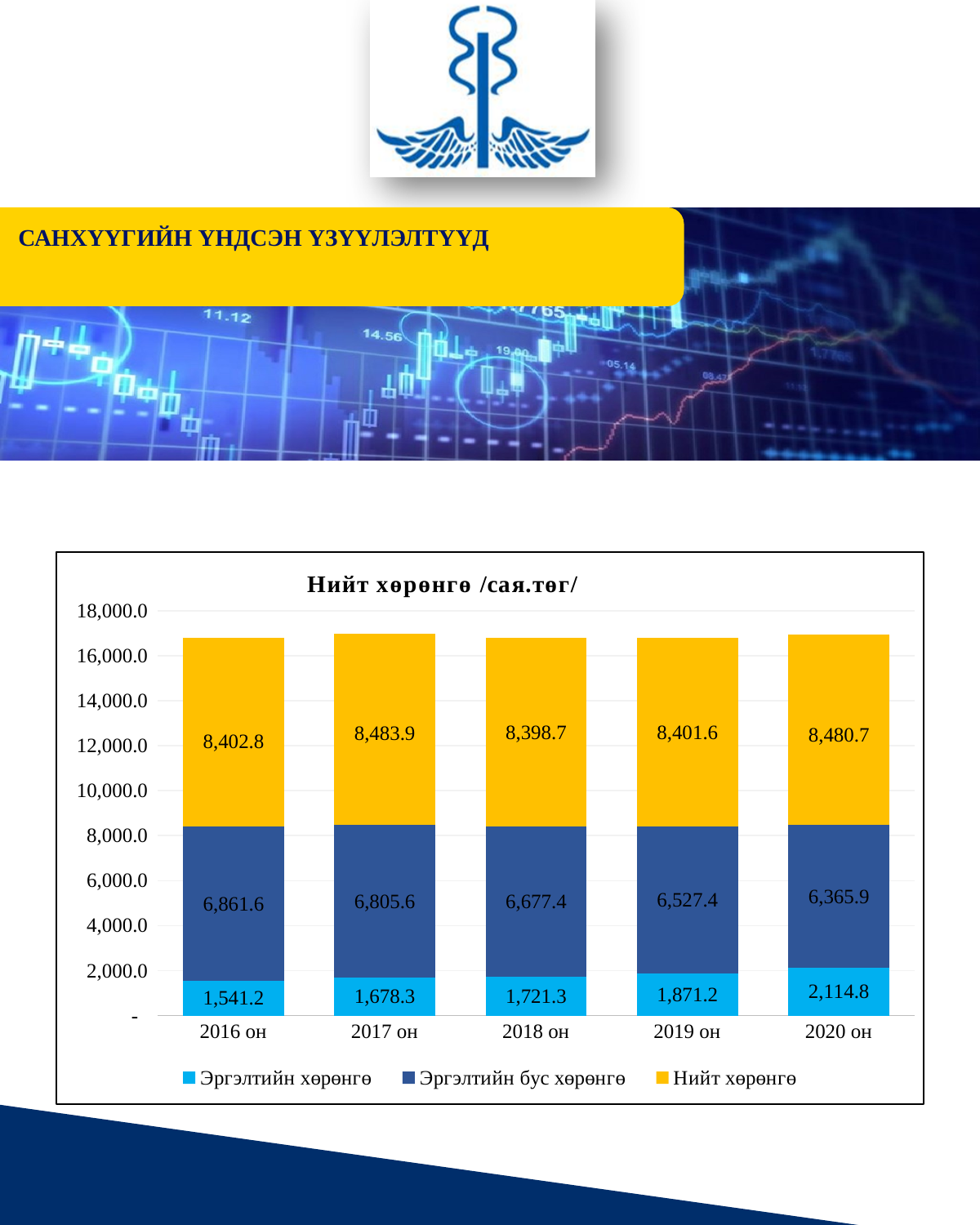
In which year is Эргэлтийн бус хөрөнгө lowest? 2020 он What is the value of Эргэлтийн хөрөнгө for 2016 он? 1,541.2 What kind of chart is shown? Stacked bar chart How does Эргэлтийн хөрөнгө change from 2016 он to 2020 он? It rises every year What is the difference between Эргэлтийн хөрөнгө in 2020 он and in 2016 он? 573.6 How many series does the legend list? 3 How many years are shown on the x axis? 5 In which year is Эргэлтийн хөрөнгө highest? 2020 он What is the value of Нийт хөрөнгө for 2018 он? 8,398.7 What is the value of Эргэлтийн бус хөрөнгө for 2019 он? 6,527.4 What is the title of the chart? Нийт хөрөнгө /сая.төг/ Which is larger: Эргэлтийн бус хөрөнгө in 2017 он or in 2020 он? 2017 он